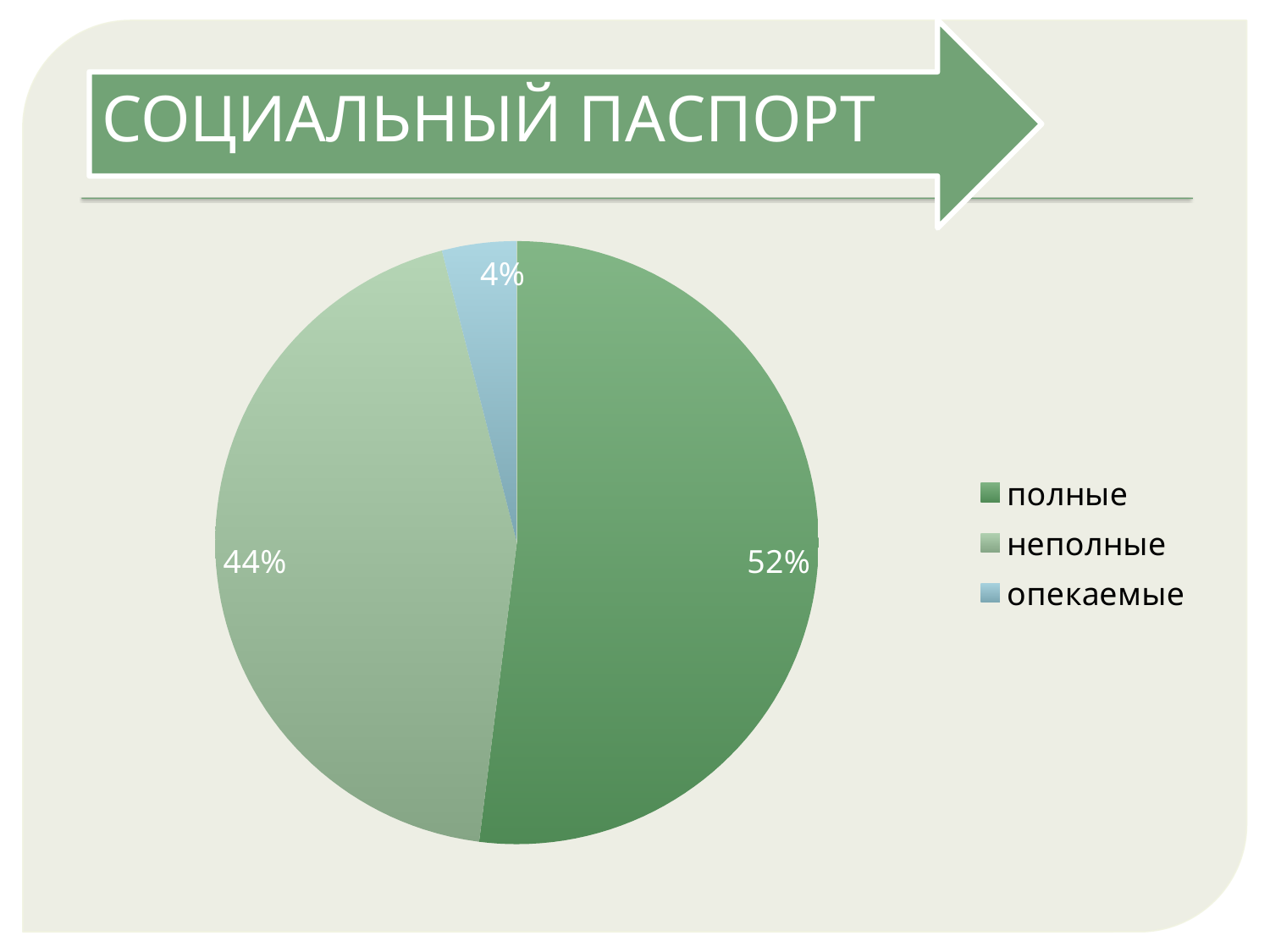
Which slice is larger, "полные" or "неполные"? полные Which category has the smallest slice of the pie? опекаемые What is the difference in percentage points between the "неполные" and "опекаемые" slices? 40 What share of the pie does the "полные" slice represent? 52% What is the difference in percentage points between the "полные" and "неполные" slices? 8 What colour is the "опекаемые" slice in the pie chart? light blue Which category has the largest slice of the pie? полные How many categories does the pie chart have? 3 What is the title of the slide containing the chart? СОЦИАЛЬНЫЙ ПАСПОРТ What share of the pie does the "неполные" slice represent? 44% What share of the pie does the "опекаемые" slice represent? 4% What kind of chart is shown on the slide? pie chart